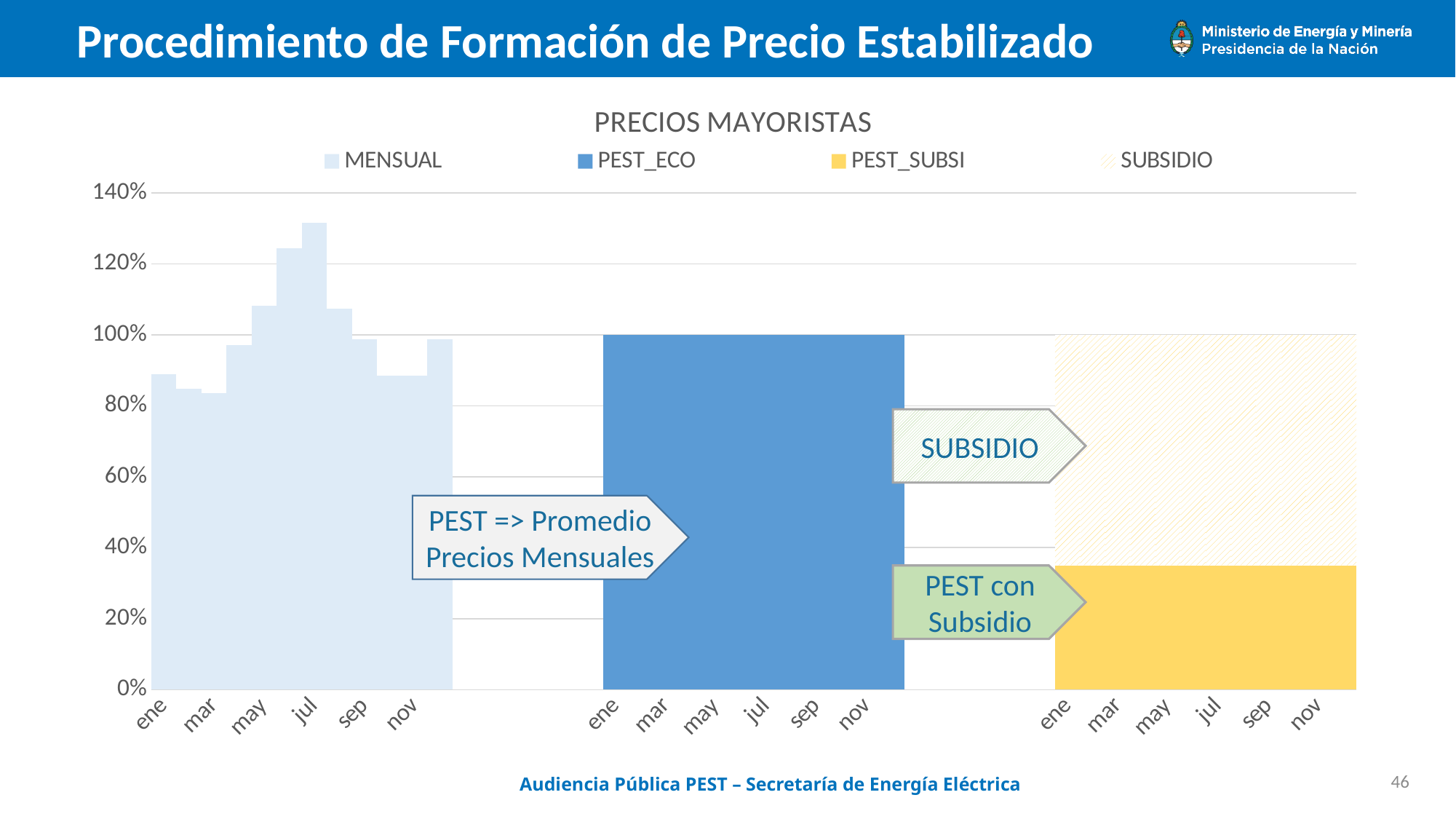
Is the MENSUAL value for ene greater or less than 100%? less Which is larger, the MENSUAL value for jul or the PEST_ECO value? MENSUAL value for jul What is the total height of the stacked PEST_SUBSI and SUBSIDIO bars? 100% How many series does the chart legend list? 4 Is the SUBSIDIO (hatched) portion of the stacked bars greater or less than 60%? greater Which series is shown in yellow in the legend? PEST_SUBSI In the MENSUAL series, which month has the highest bar? jul Is the PEST_SUBSI value greater or less than 40%? less What is the title of the chart? PRECIOS MAYORISTAS What kind of chart is shown on the slide? Bar chart What value do the PEST_ECO bars reach on the y axis? 100%